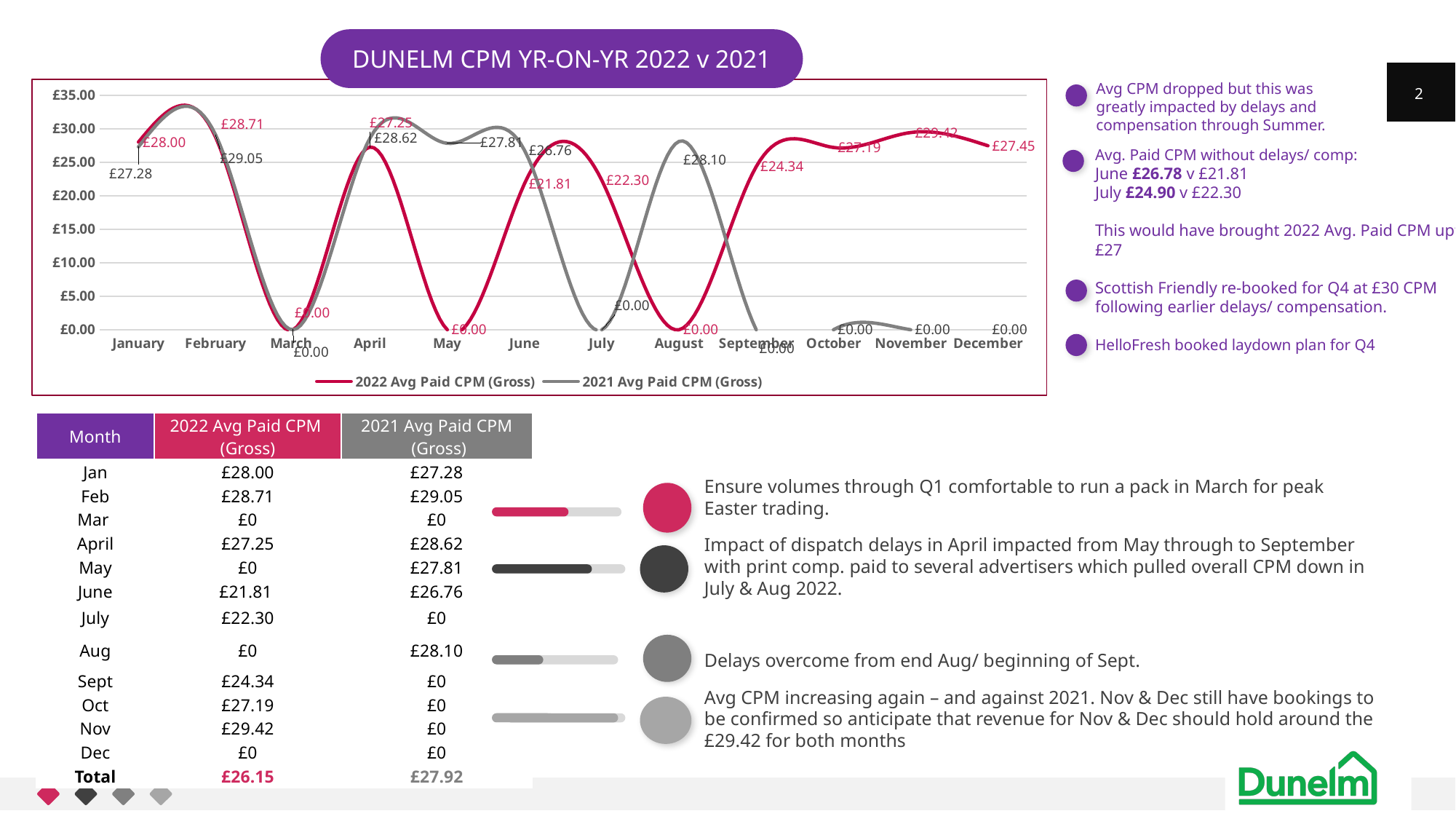
Is the 2022 Avg Paid CPM (Gross) value for November greater or less than £25.00? greater How many series does the chart legend list? 2 Does the 2022 Avg Paid CPM (Gross) line rise or fall from September to November? Rise What type of chart is shown on the slide? Line chart In June, which series has the higher value: 2022 Avg Paid CPM (Gross) or 2021 Avg Paid CPM (Gross)? 2021 Avg Paid CPM (Gross) What is the 2022 Avg Paid CPM (Gross) for September? £24.34 What is the 2022 Avg Paid CPM (Gross) for June? £21.81 Which month has the highest 2021 Avg Paid CPM (Gross) value? February What is the difference between the 2021 and 2022 Avg Paid CPM (Gross) values for February? £0.34 What is the 2021 Avg Paid CPM (Gross) for August? £28.10 What is the difference between the 2021 and 2022 Avg Paid CPM (Gross) values for June? £4.95 How many months are plotted along the x axis of the chart? 12